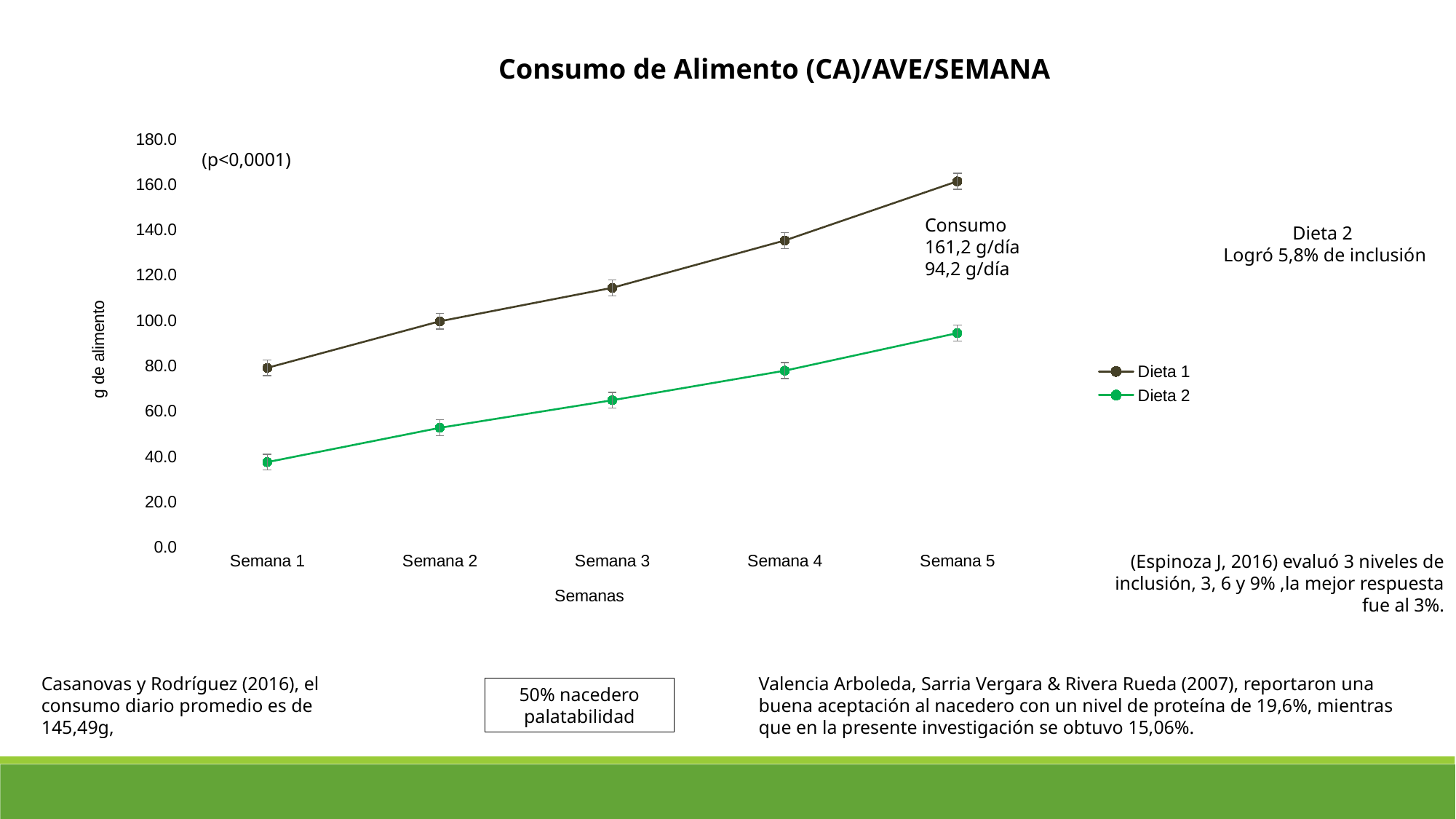
How many weeks (categories) are plotted on the x axis? 5 At Semana 3, which series has the larger value, Dieta 1 or Dieta 2? Dieta 1 Is the value for Dieta 1 at Semana 5 greater or less than 140? greater In which week is the value for Dieta 1 highest? Semana 5 In which week is the value for Dieta 2 lowest? Semana 1 What is the label of the y axis? g de alimento Is the value for Dieta 1 at Semana 4 greater or less than 120? greater What is the title of the chart? Consumo de Alimento (CA)/AVE/SEMANA Do the values for Dieta 1 rise or fall from Semana 1 to Semana 5? rise Is the value for Dieta 2 at Semana 1 greater or less than 60? less What kind of chart is shown on the slide? line chart How many series does the legend list? 2